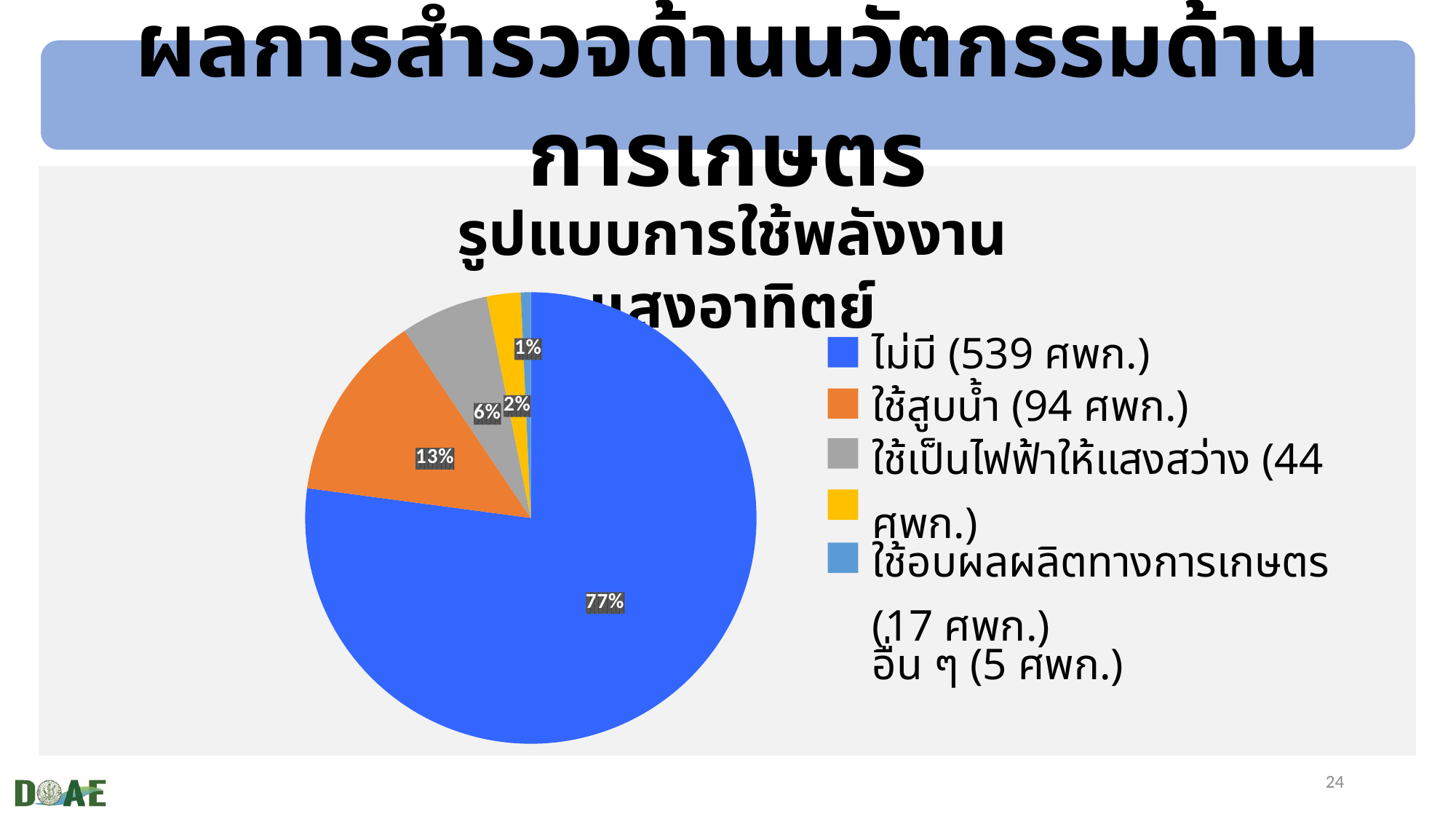
What percentage of the pie is labelled for ใช้สูบน้ำ? 13% How many slices does the pie chart have? 5 What percentage of the pie is labelled for ใช้อบผลผลิตทางการเกษตร? 2% Which category has the smallest share of the pie chart? อื่น ๆ What kind of chart is shown on the slide? Pie chart Which category has the largest share of the pie chart? ไม่มี What percentage of the pie is labelled for ไม่มี? 77% How many ศพก. are listed in the legend for ไม่มี? 539 ศพก. Which slice is larger, ใช้เป็นไฟฟ้าให้แสงสว่าง or ใช้อบผลผลิตทางการเกษตร? ใช้เป็นไฟฟ้าให้แสงสว่าง How many ศพก. are listed in the legend for ใช้สูบน้ำ? 94 ศพก. What is the difference in percentage points between the ไม่มี slice and the ใช้สูบน้ำ slice? 64